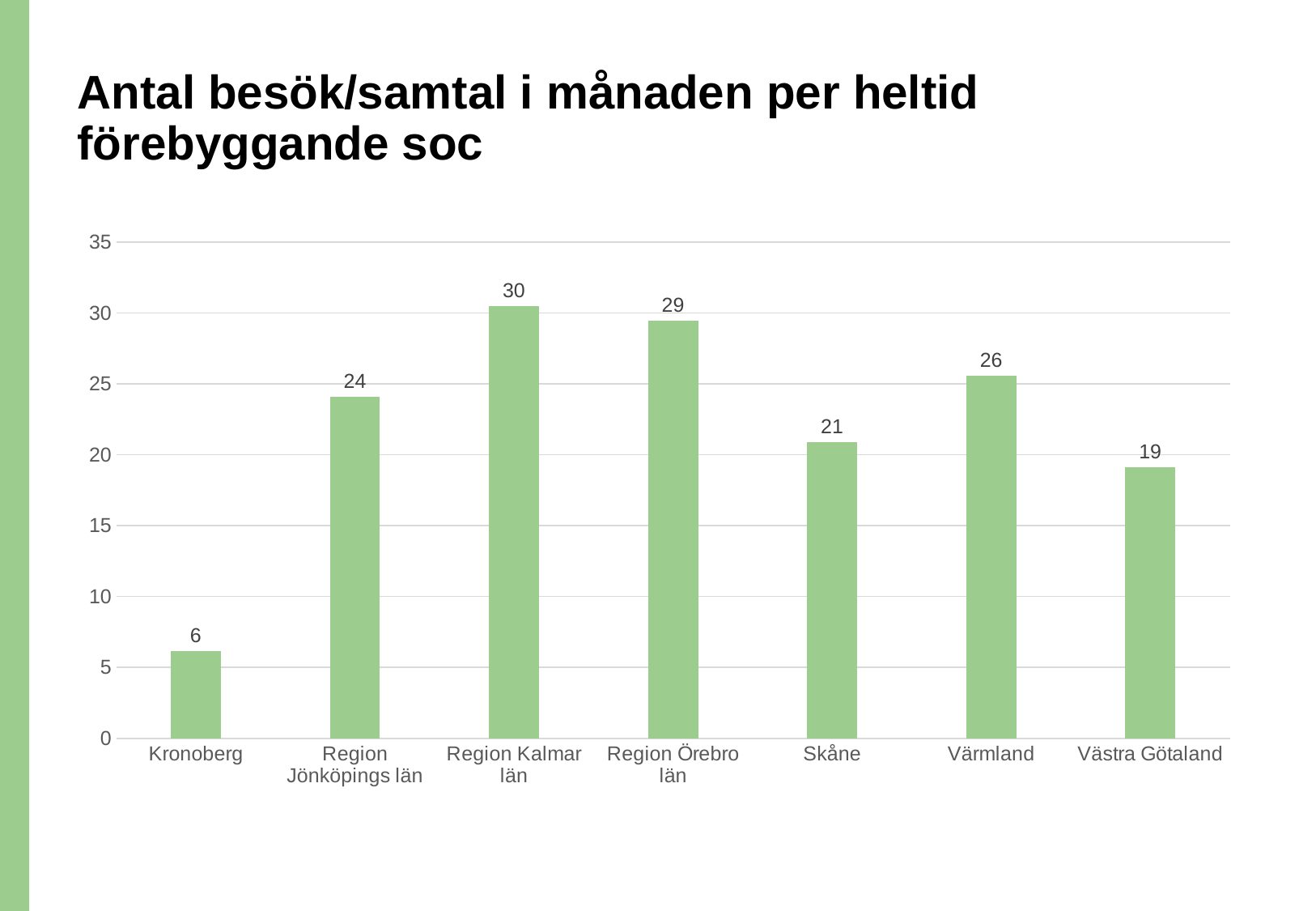
What is the value for Kronoberg? 6 What is the difference between the values for Region Jönköpings län and Skåne? 3 Is the value for Skåne greater or less than 25? less What is the value for Värmland? 26 What is the value for Västra Götaland? 19 Which is larger, the value for Region Örebro län or the value for Värmland? Region Örebro län What is the value for Region Kalmar län? 30 Which category has the lowest value? Kronoberg What is the title of the chart? Antal besök/samtal i månaden per heltid förebyggande soc Which category has the highest value? Region Kalmar län How many categories are shown on the x axis? 7 What kind of chart is shown on the slide? bar chart